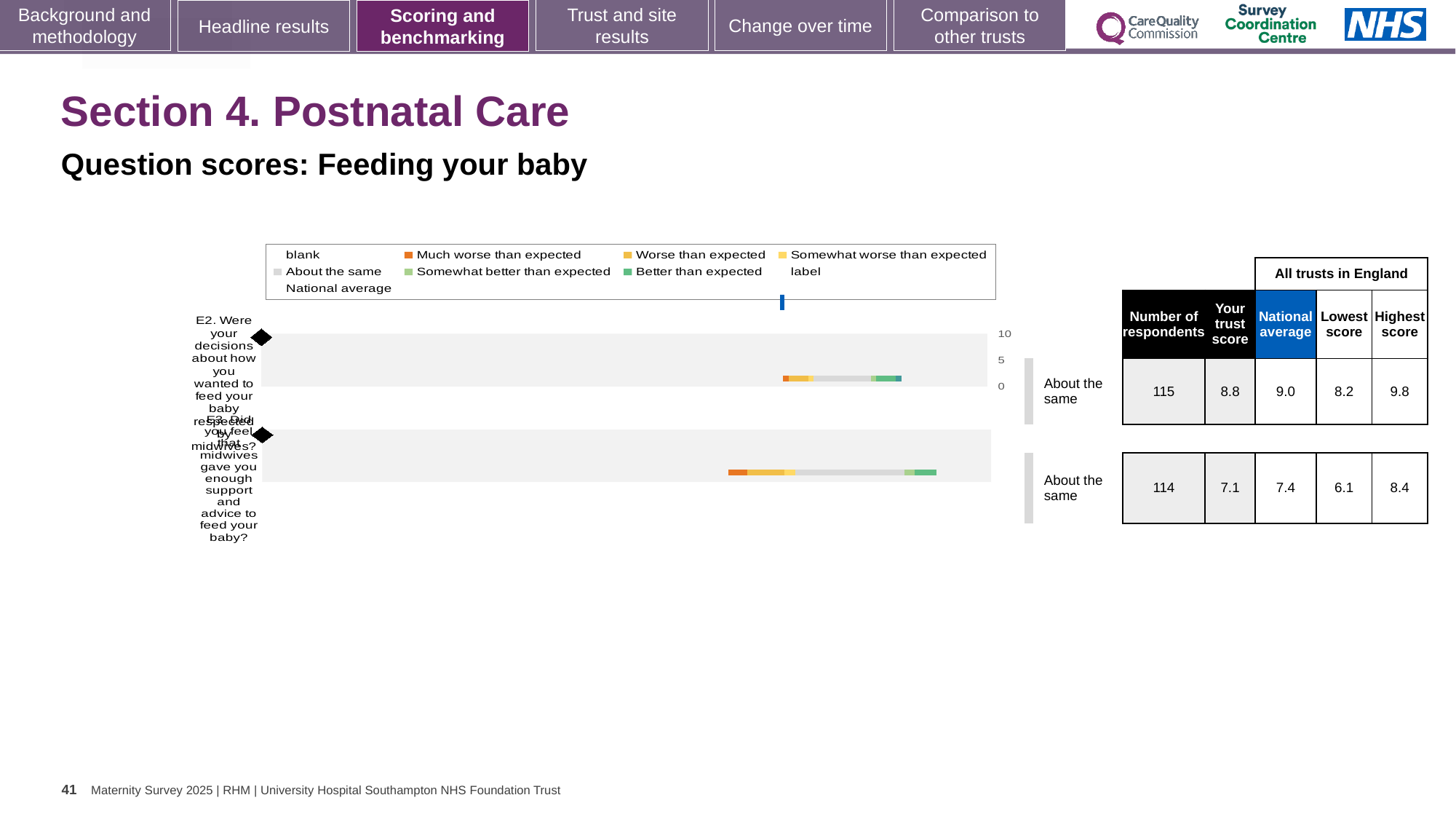
What kind of chart is shown on the slide? bar chart How many respondents answered question E2? 115 What is the lowest score among all trusts in England for question E3? 6.1 What is the subtitle describing the chart's content? Question scores: Feeding your baby What is the difference between the highest and lowest scores among all trusts in England for question E2? 1.6 Which question has the higher trust score, E2 or E3? E2 What is the trust score for question E2 (decisions about how you wanted to feed your baby respected by midwives)? 8.8 What is the national average for question E3 (midwives gave you enough support and advice to feed your baby)? 7.4 What benchmark category is shown for question E3? About the same For question E2, is the trust score or the national average higher? National average By how much does the national average exceed the trust score for question E3? 0.3 How many questions (categories) are plotted in the chart? 2